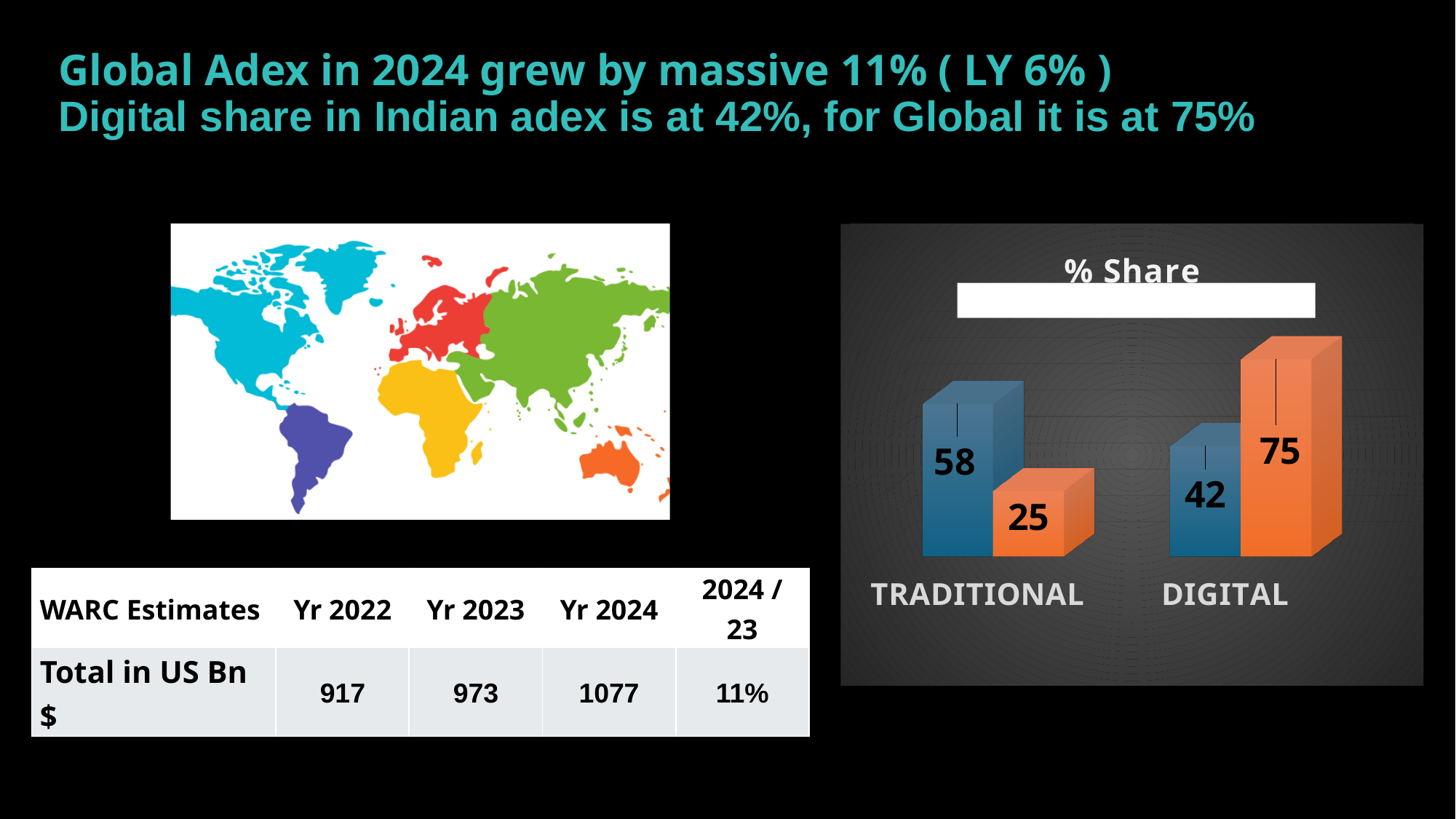
In the % Share chart, what is the difference between the blue bar and the orange bar for TRADITIONAL? 33 In the % Share chart, which bar has the highest value? Orange bar for DIGITAL In the % Share chart, which bar has the lowest value? Orange bar for TRADITIONAL In the % Share chart, which is larger for DIGITAL: the blue bar or the orange bar? Orange bar How many categories are shown on the x axis of the % Share chart? 2 In the % Share chart, what is the value of the blue bar for TRADITIONAL? 58 What kind of chart is the % Share chart? Bar chart In the % Share chart, what is the value of the orange bar for TRADITIONAL? 25 What is the title of the chart on the slide? % Share In the % Share chart, what is the difference between the orange bar for DIGITAL and the orange bar for TRADITIONAL? 50 In the % Share chart, what is the value of the blue bar for DIGITAL? 42 In the % Share chart, what is the value of the orange bar for DIGITAL? 75